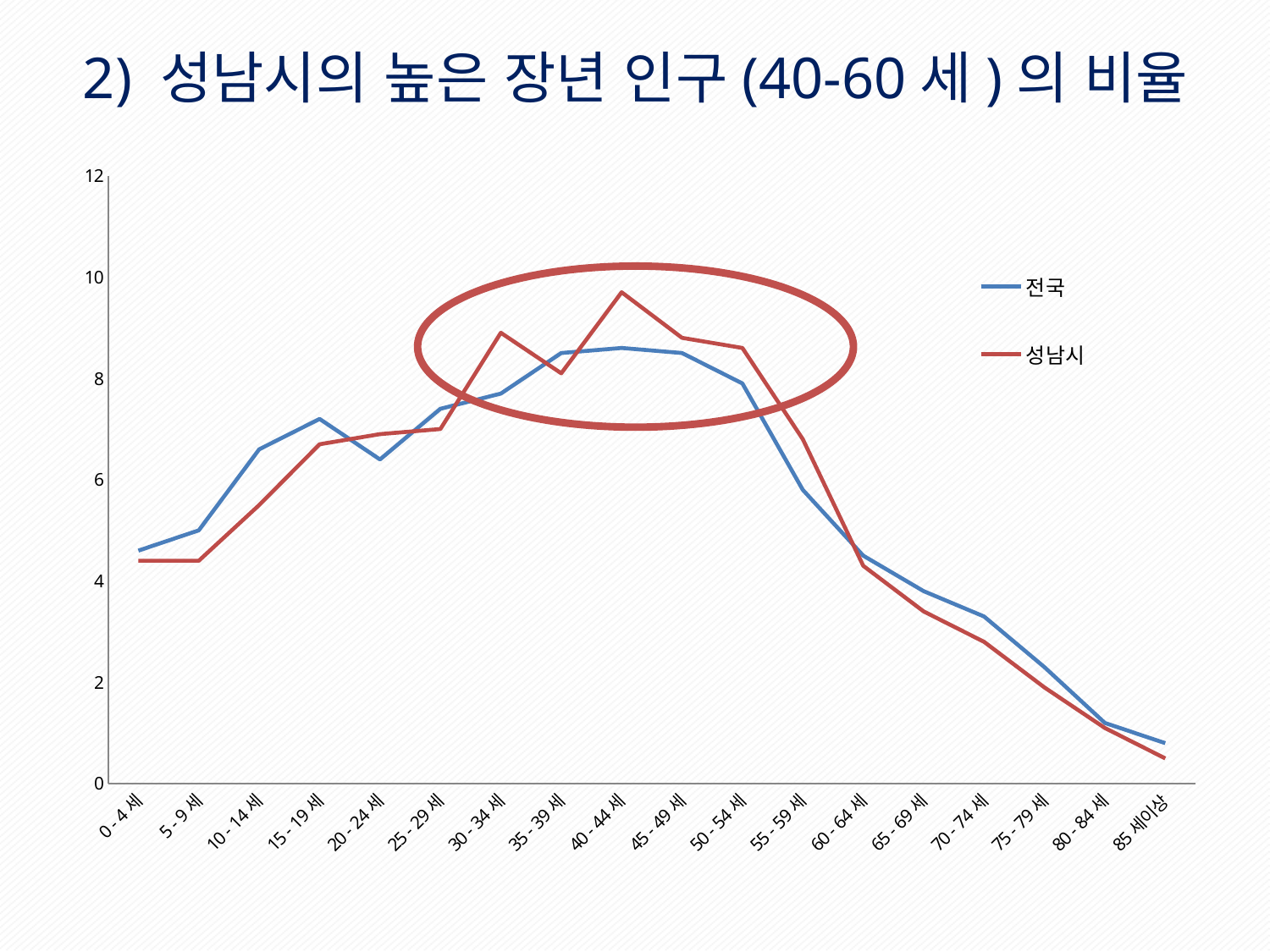
What kind of chart is shown on the slide? line chart Does the 성남시 line rise or fall from 40 - 44 세 to 85 세이상? fall Is the value for 성남시 at 40 - 44 세 greater or less than 8? greater Is the value for 전국 at 0 - 4 세 greater or less than 6? less At 40 - 44 세, which series has the larger value, 전국 or 성남시? 성남시 How many age categories are shown on the x axis? 18 Which age category has the highest value for 성남시? 40 - 44 세 Which age category has the lowest value for 성남시? 85 세이상 At 10 - 14 세, which series has the larger value, 전국 or 성남시? 전국 Which age category has the lowest value for 전국? 85 세이상 How many series does the legend list? 2 Is the value for 성남시 at 85 세이상 greater or less than 2? less